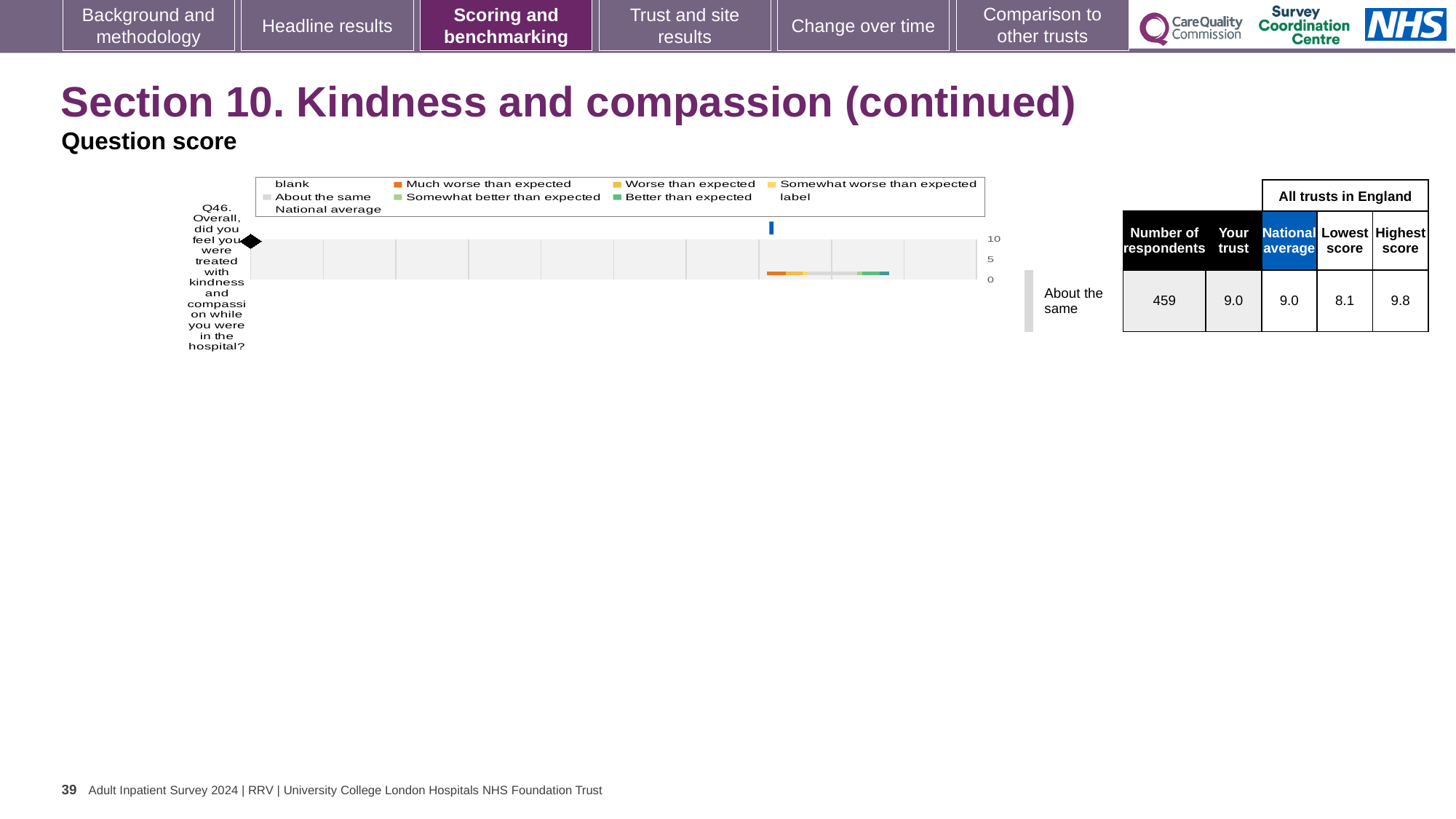
What benchmark category is the trust's Q46 result labelled as on the slide? About the same What is the highest score among all trusts in England for Q46? 9.8 What is the national average score for Q46 shown on the slide? 9.0 What is the 'Your trust' score for Q46 shown on the slide? 9.0 What is the maximum value shown on the chart's axis? 10 What is the difference between the highest and lowest scores for Q46 across all trusts in England? 1.7 What is the lowest score among all trusts in England for Q46? 8.1 What kind of chart is shown on the slide for Q46? bar chart How many questions are plotted in the chart on this slide? 1 Which is larger for Q46: the highest score across all trusts or the trust's own score? the highest score across all trusts How many respondents answered Q46? 459 Is the trust's score for Q46 greater or less than 5 on the chart axis? greater